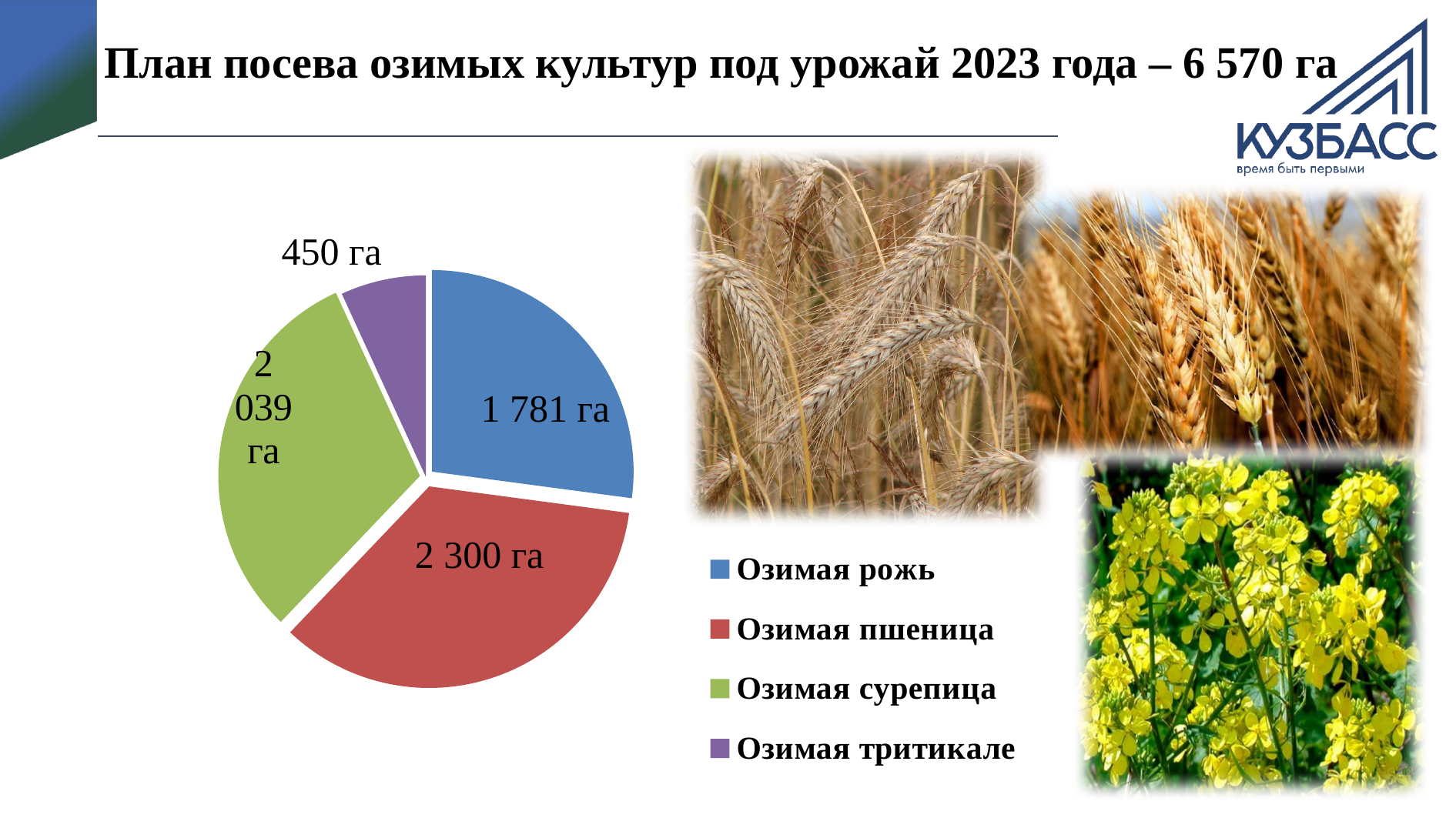
What is the planned sowing area for Озимая сурепица? 2 039 га Which has a larger planned area, Озимая сурепица or Озимая рожь? Озимая сурепица What is the planned sowing area for Озимая рожь? 1 781 га How many crops are shown in the pie chart? 4 Which crop has the smallest planned sowing area? Озимая тритикале What colour represents Озимая сурепица in the pie chart? Green What is the difference between the areas for Озимая сурепица and Озимая тритикале? 1 589 га What is the planned sowing area for Озимая тритикале? 450 га How much larger is the area for Озимая пшеница than for Озимая рожь? 519 га Which crop has the largest planned sowing area? Озимая пшеница What is the planned sowing area for Озимая пшеница? 2 300 га What type of chart is shown on the slide? Pie chart